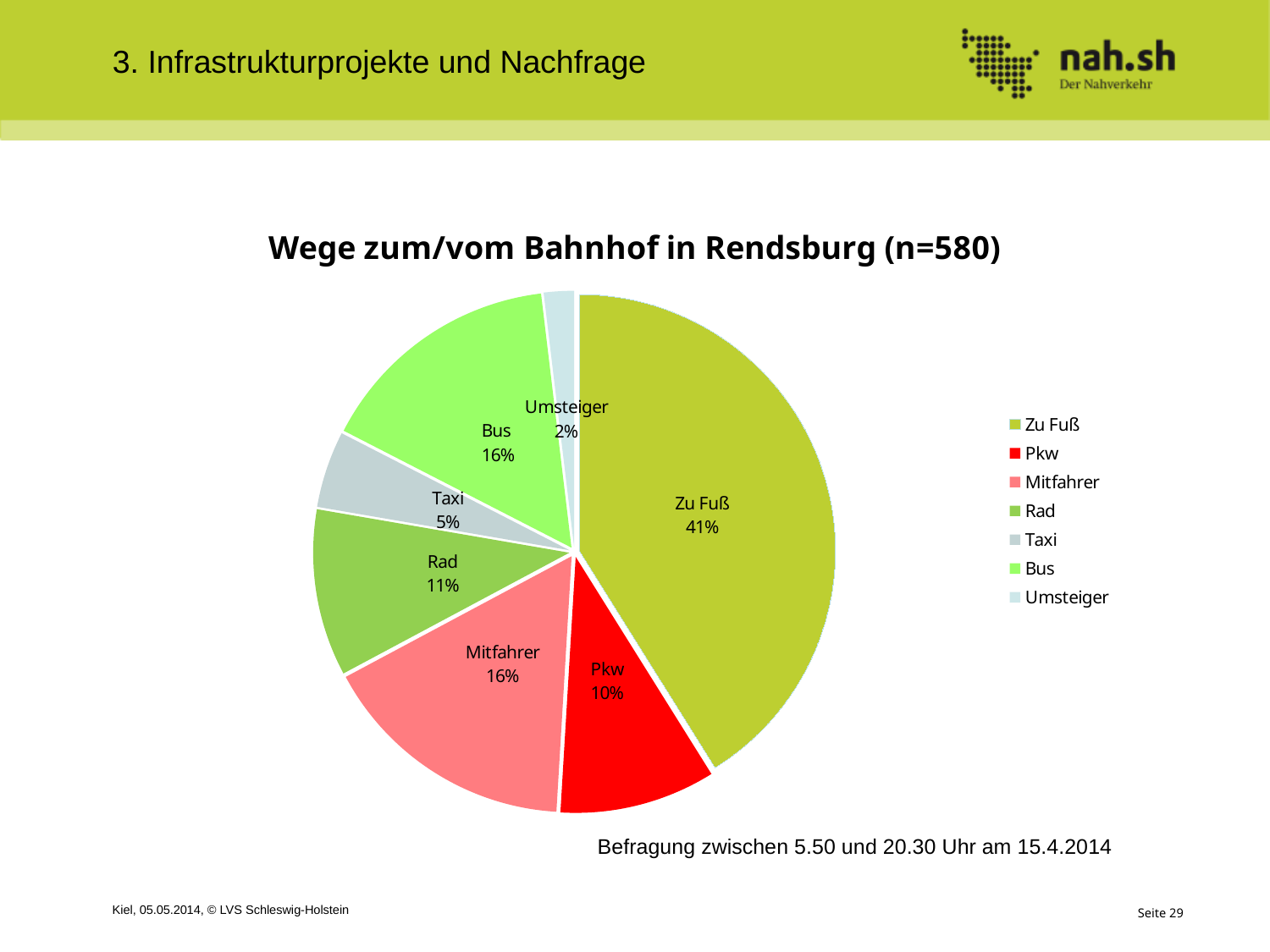
Which category has the largest share of the pie? Zu Fuß Which category has the smallest share of the pie? Umsteiger What is the title of the chart? Wege zum/vom Bahnhof in Rendsburg (n=580) What colour is the Pkw slice? Red What is the difference in percentage points between Zu Fuß and Bus? 25 What is the value shown for Taxi? 5% How many categories does the pie chart show? 7 What is the value shown for Rad? 11% What is the value shown for Pkw? 10% Which is larger, the share for Rad or the share for Pkw? Rad What share of the pie does Zu Fuß have? 41% What kind of chart is shown on the slide? Pie chart